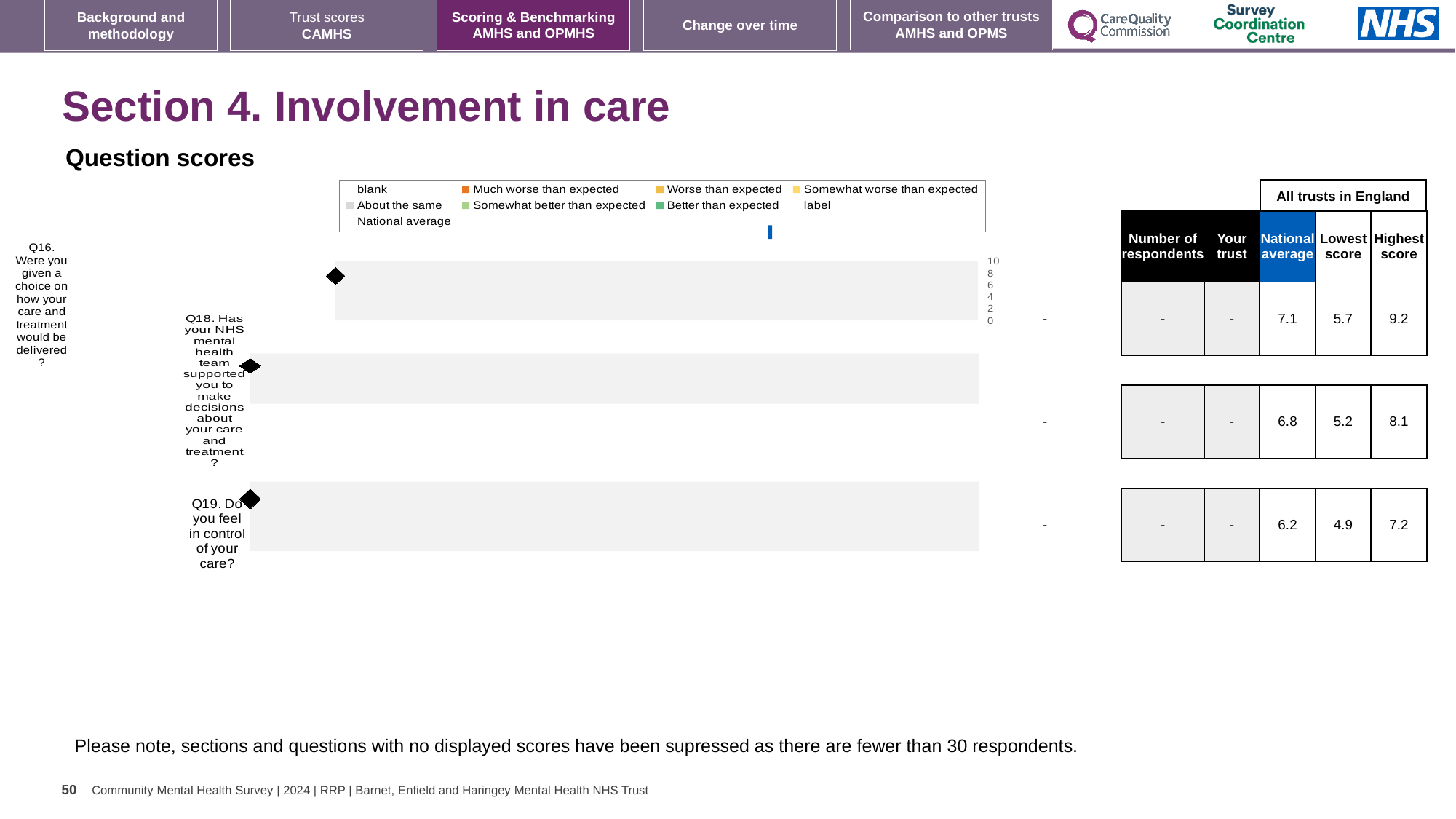
What is the maximum value shown on the chart's numeric axis? 10 In the table beside the chart, what is shown in the 'Your trust' column for Q16? - In the table beside the chart, what is the National average score for Q16 (choice on how care and treatment would be delivered)? 7.1 In the table beside the chart, which has the larger National average: Q18 or Q19? Q18 In the table beside the chart, which question has the lowest Lowest score? Q19 What kind of chart is shown under 'Question scores'? bar chart In the table beside the chart, what is the Lowest score for Q19 (feel in control of your care)? 4.9 In the table beside the chart, what is the Highest score for Q18 (supported to make decisions about care and treatment)? 8.1 In the table beside the chart, which question has the highest National average score? Q16 In the table beside the chart, what is the difference between the Highest score and the Lowest score for Q16? 3.5 According to the legend, what does the diamond marker on the chart represent? National average How many questions (categories) are listed on the chart's vertical axis? 3